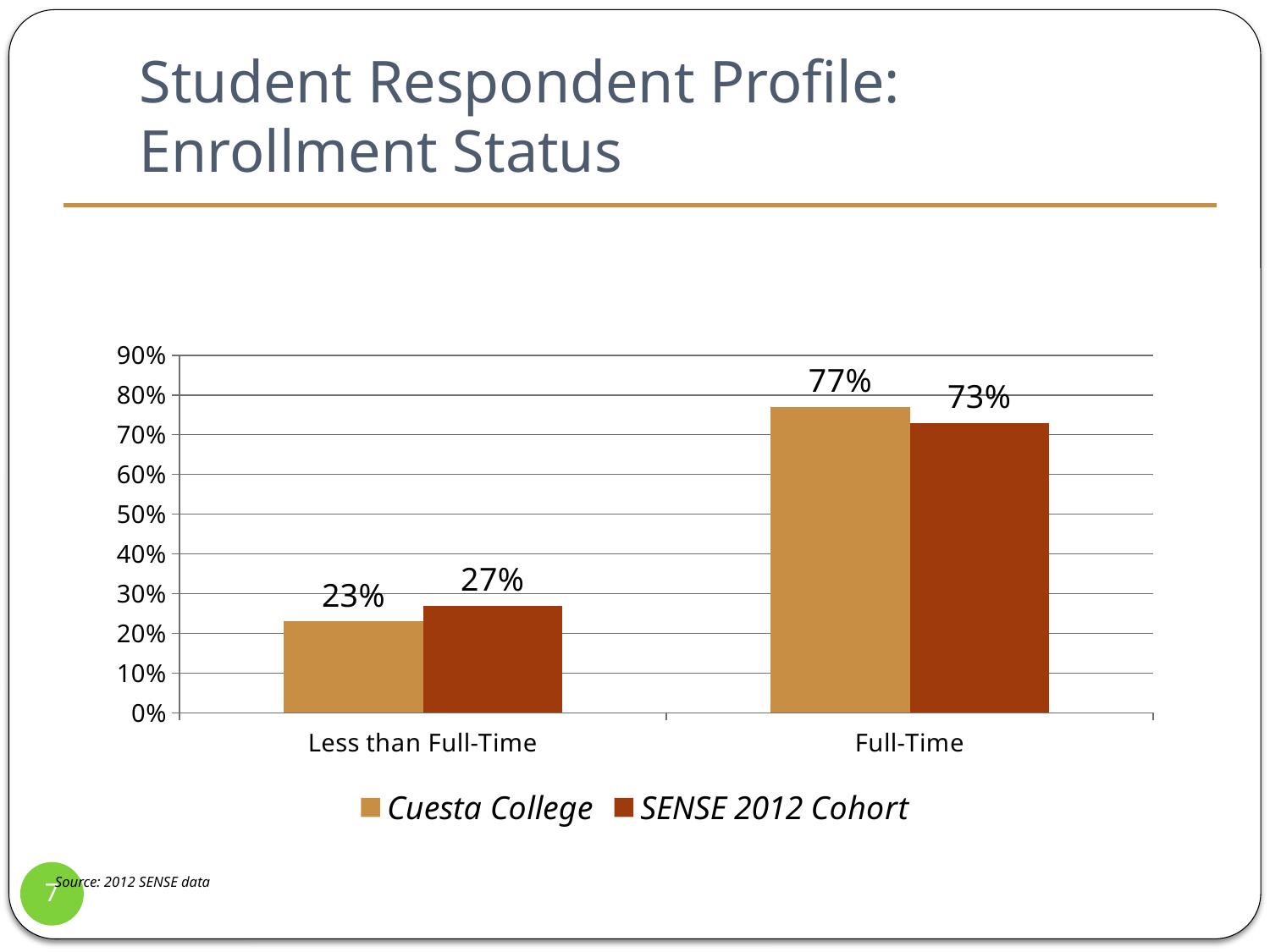
What is the SENSE 2012 Cohort value for Less than Full-Time enrollment? 27% Which is larger for Less than Full-Time enrollment: Cuesta College or SENSE 2012 Cohort? SENSE 2012 Cohort What percentage of Cuesta College respondents are enrolled Less than Full-Time? 23% What percentage of the SENSE 2012 Cohort is enrolled Full-Time? 73% How many enrollment status categories are shown on the x axis? 2 How many series does the legend list? 2 What kind of chart is shown on the slide? Bar chart What is the difference between the Cuesta College and SENSE 2012 Cohort values for Full-Time enrollment? 4% Which enrollment status category has the highest value for Cuesta College? Full-Time What is the Cuesta College value for Full-Time enrollment? 77% What is the title of the slide containing the chart? Student Respondent Profile: Enrollment Status Which series has the lowest value in the Less than Full-Time category? Cuesta College